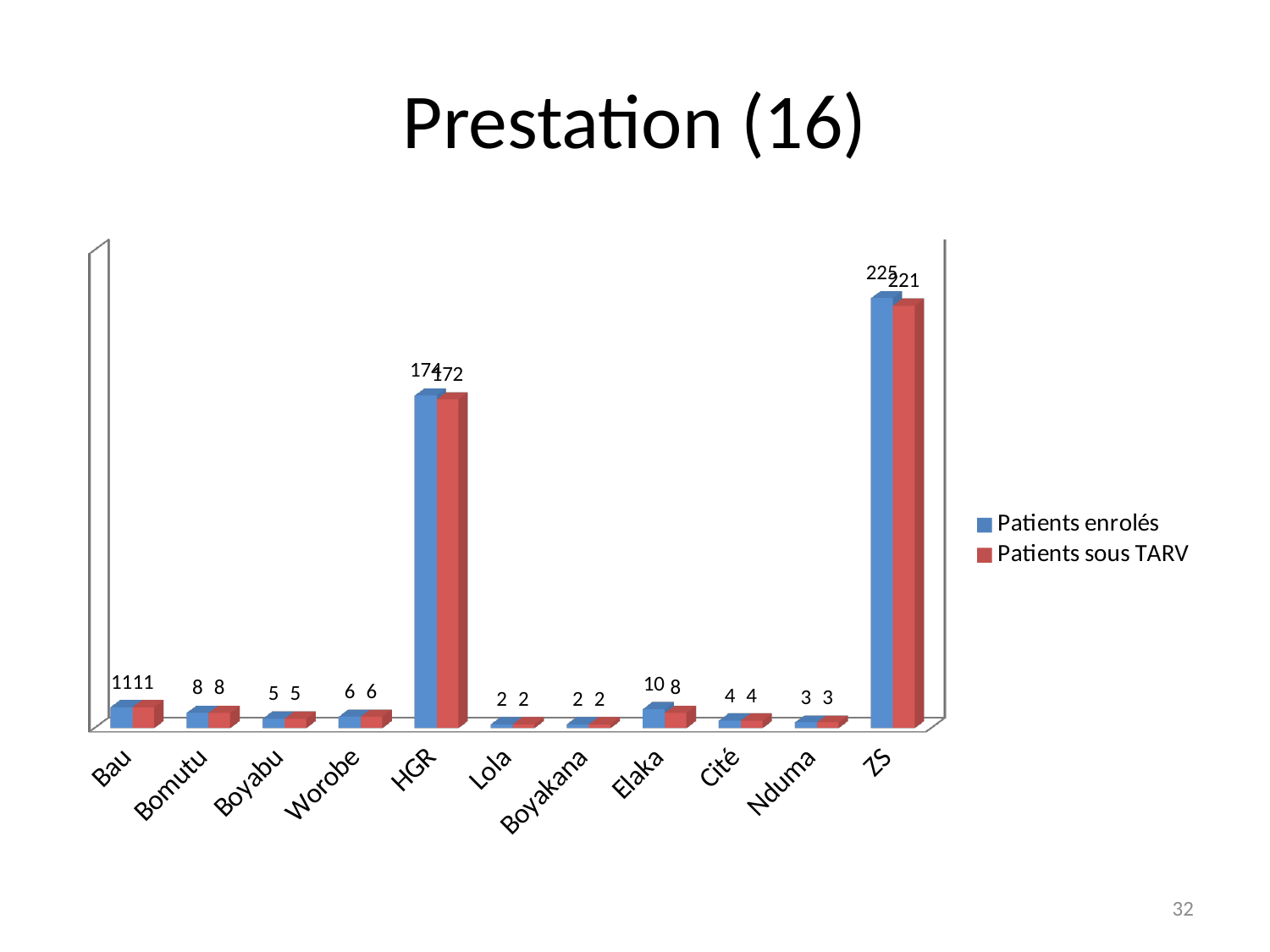
What is the value of Patients sous TARV for Elaka? 8 What is the value of Patients enrolés for HGR? 174 How many series does the legend list? 2 Which colour represents Patients sous TARV in the legend? Red What is the difference between Patients enrolés and Patients sous TARV for ZS? 4 What type of chart is shown on the slide? Bar chart What is the value of Patients enrolés for Nduma? 3 How many categories are shown on the x axis? 11 Which is larger, Patients enrolés for Bau or Patients enrolés for Bomutu? Bau Which category has the highest value for Patients enrolés? ZS What is the difference between Patients enrolés and Patients sous TARV for HGR? 2 What is the value of Patients sous TARV for ZS? 221